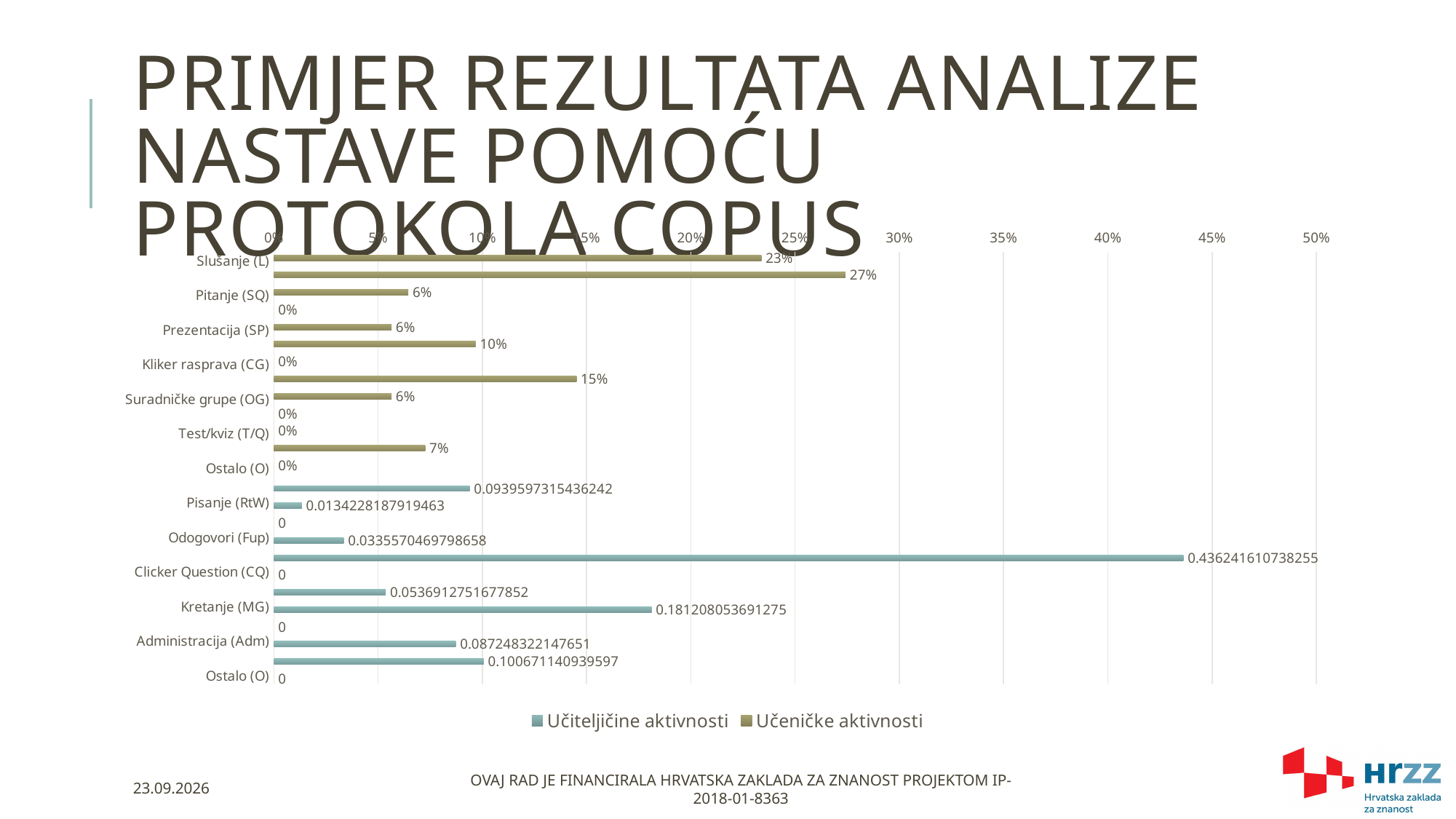
What is the difference between the bars labelled 27% and 23%? 4% What value is labelled on the bar aligned with the Kretanje (MG) label? 0.181208053691275 What is the highest percentage value labelled among the Učeničke aktivnosti bars? 27% How many series does the legend list? 2 What value is labelled on the bar aligned with the Administracija (Adm) label? 0.087248322147651 Is the longest bar in the chart greater or less than 40%? greater What are the two series named in the legend? Učiteljičine aktivnosti and Učeničke aktivnosti Which is larger, the bar labelled 27% or the bar labelled 23%? 27% What value is labelled on the bar aligned with the Slušanje (L) label? 23% How many category labels are shown on the vertical axis? 13 What kind of chart is shown on the slide? bar chart What is the highest value labelled on any bar in the chart? 0.436241610738255